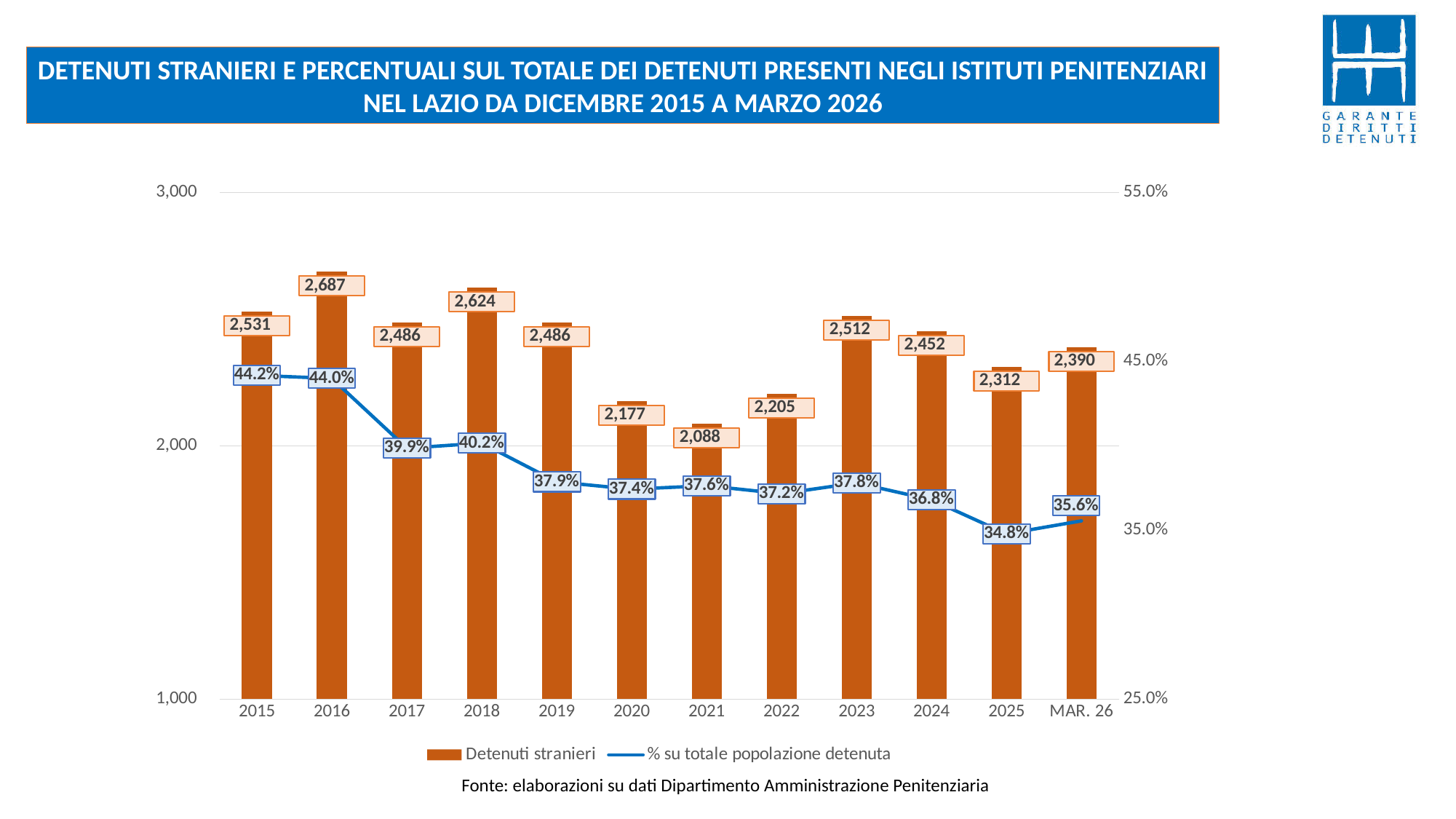
How many series does the legend list? 2 What kind of chart is this? Combined bar and line chart Does the % su totale popolazione detenuta line generally rise or fall from 2015 to 2025? Fall What is the value of Detenuti stranieri for MAR. 26? 2,390 How many years are shown on the x axis? 12 Which year has the highest value of Detenuti stranieri? 2016 What is the value of % su totale popolazione detenuta for 2025? 34.8% What is the difference in Detenuti stranieri between 2016 and 2021? 599 What is the value of Detenuti stranieri for 2016? 2,687 Which year has the lowest value of % su totale popolazione detenuta? 2025 Which is larger, the Detenuti stranieri value for 2023 or for 2024? 2023 Which year has the lowest value of Detenuti stranieri? 2021